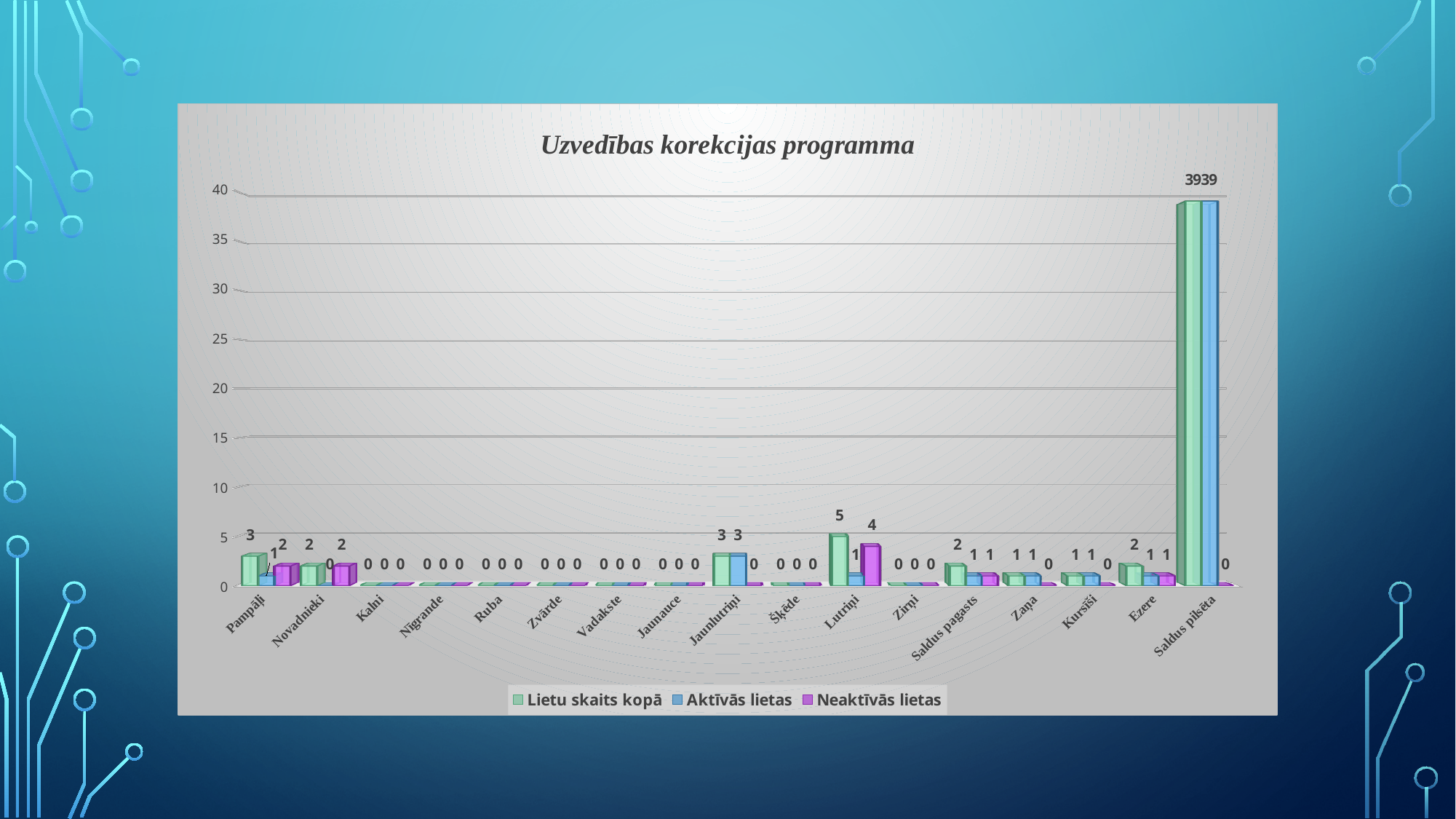
What is the difference between Lietu skaits kopā for Lutriņi and for Pampāļi? 2 How many categories are shown on the x axis? 17 What kind of chart is shown on the slide? bar chart What is the value of Lietu skaits kopā for Jaunlutriņi? 3 What is the title of the chart? Uzvedības korekcijas programma What is the value of Aktīvās lietas for Pampāļi? 1 Is the value of Aktīvās lietas for Saldus pilsēta greater or less than 35? greater What is the value of Lietu skaits kopā for Saldus pilsēta? 39 Which is larger: Neaktīvās lietas for Lutriņi or Neaktīvās lietas for Novadnieki? Lutriņi Which category has the highest value of Lietu skaits kopā? Saldus pilsēta What is the value of Neaktīvās lietas for Lutriņi? 4 How many series does the legend list? 3